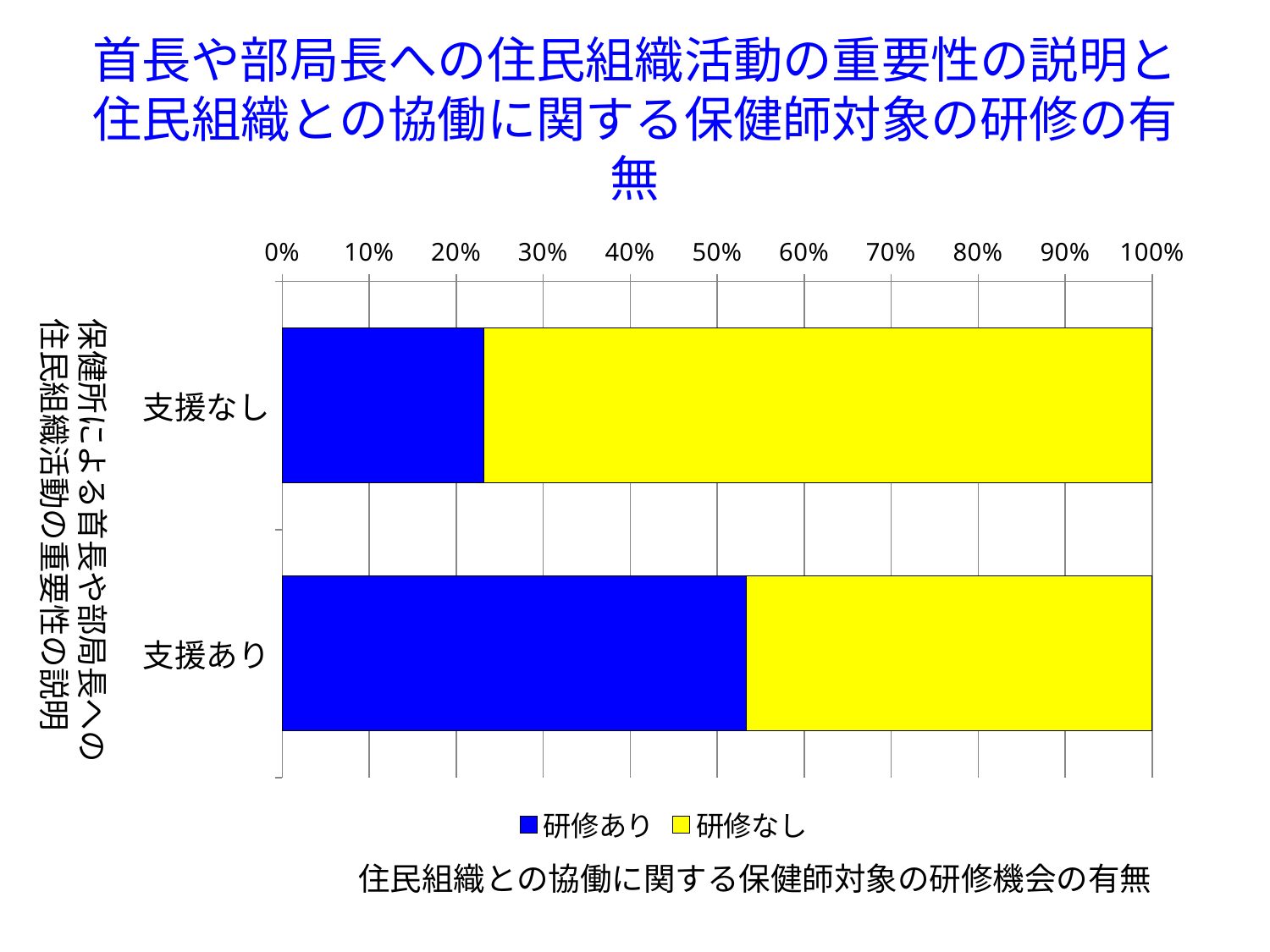
Which category has the highest 研修あり share? 支援あり Is the 研修あり share for 支援なし greater or less than 20%? greater Is the 研修あり share for 支援あり greater or less than 50%? greater What is the label of the horizontal axis below the legend? 住民組織との協働に関する保健師対象の研修機会の有無 Which colour represents 研修なし in the legend? yellow How many series does the legend list? 2 Which category has the larger 研修なし share, 支援あり or 支援なし? 支援なし Which category has the larger 研修あり share, 支援あり or 支援なし? 支援あり How many categories are plotted on the vertical axis? 2 What kind of chart is shown on the slide? bar chart Is the 研修あり share for 支援あり greater or less than 60%? less